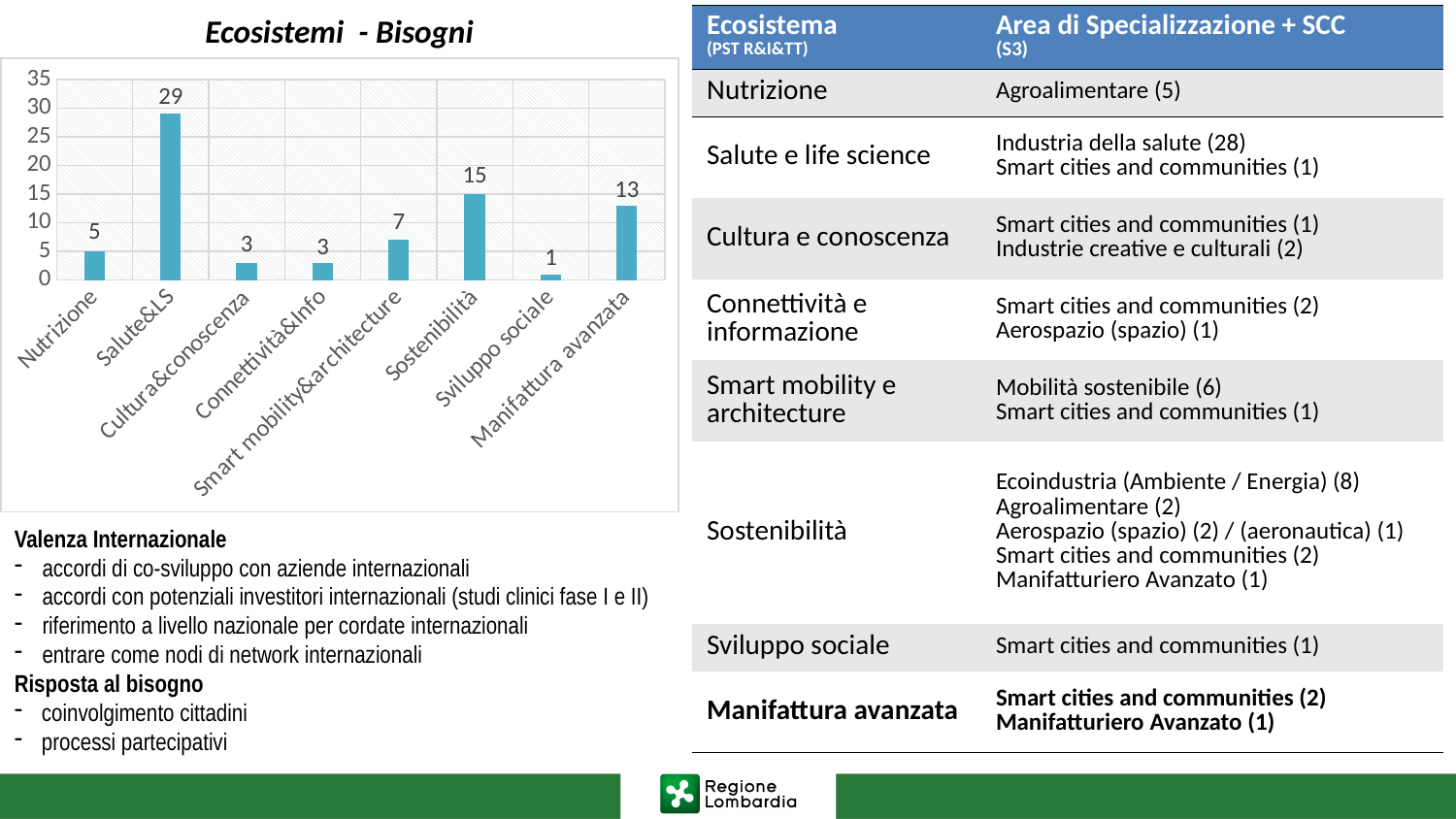
What is the value for Manifattura avanzata in the chart? 13 What is the title of the chart? Ecosistemi - Bisogni What kind of chart is shown on the slide? bar chart How many categories are shown in the chart? 8 What is the value for Sostenibilità in the chart? 15 What is the difference between the values for Salute&LS and Sostenibilità? 14 What is the value for Smart mobility&architecture in the chart? 7 What is the value for Salute&LS in the chart? 29 Which is larger, the value for Nutrizione or the value for Smart mobility&architecture? Smart mobility&architecture Which category has the highest value in the chart? Salute&LS Is the value for Manifattura avanzata greater or less than 10? greater Which category has the lowest value in the chart? Sviluppo sociale